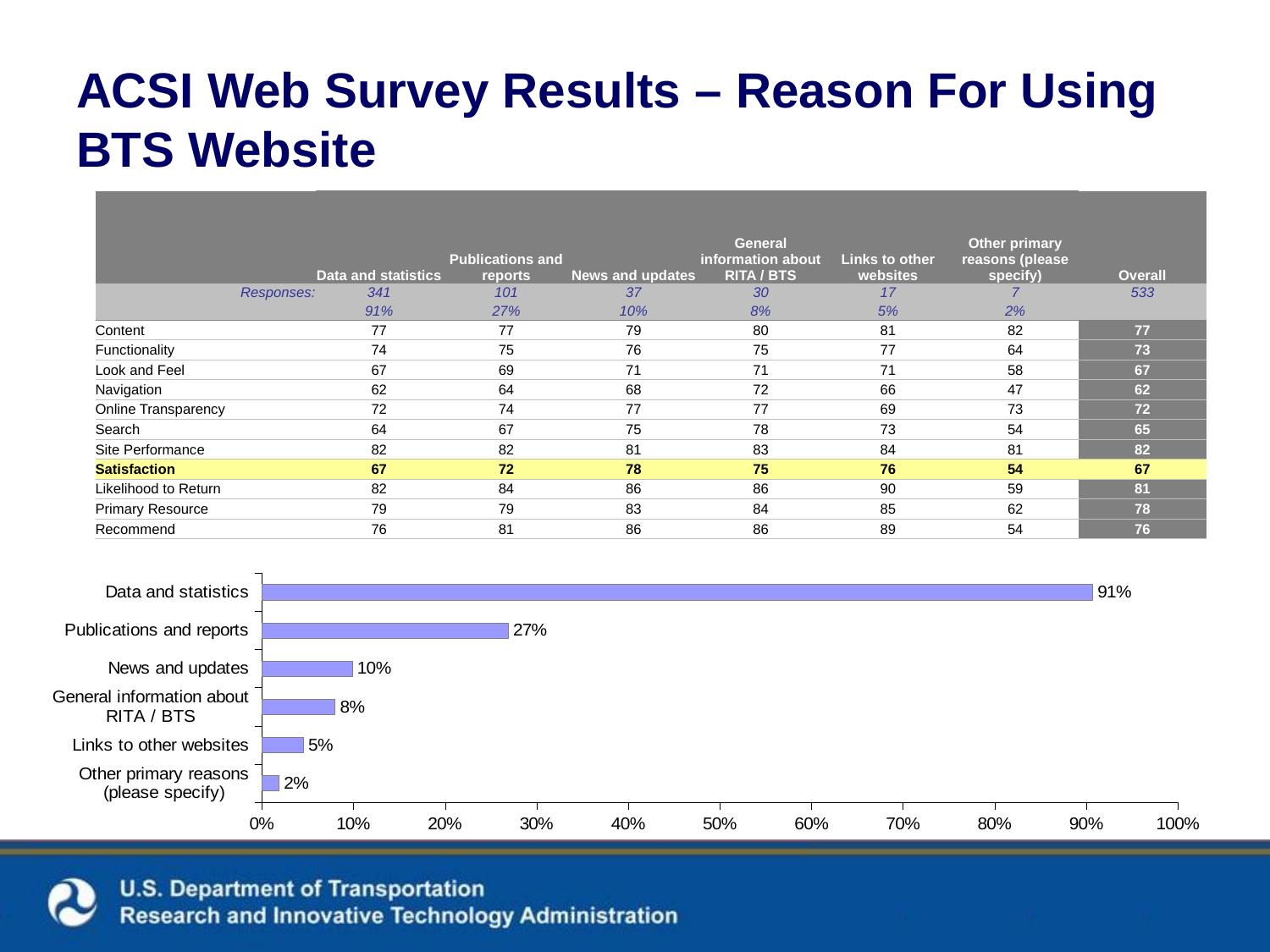
What is the value for Links to other websites in the bar chart? 5% Which category has the lowest value in the bar chart? Other primary reasons (please specify) What is the difference between the values for Data and statistics and Publications and reports in the bar chart? 64% What kind of chart is shown on the slide? bar chart Which is larger in the bar chart: News and updates or Links to other websites? News and updates Which category has the highest value in the bar chart? Data and statistics What is the value for Data and statistics in the bar chart? 91% What is the value for Publications and reports in the bar chart? 27% What is the difference between the values for News and updates and General information about RITA / BTS in the bar chart? 2% What is the maximum value shown on the x axis of the bar chart? 100% Is the value for Publications and reports in the bar chart greater or less than 30%? less How many categories are shown in the bar chart? 6